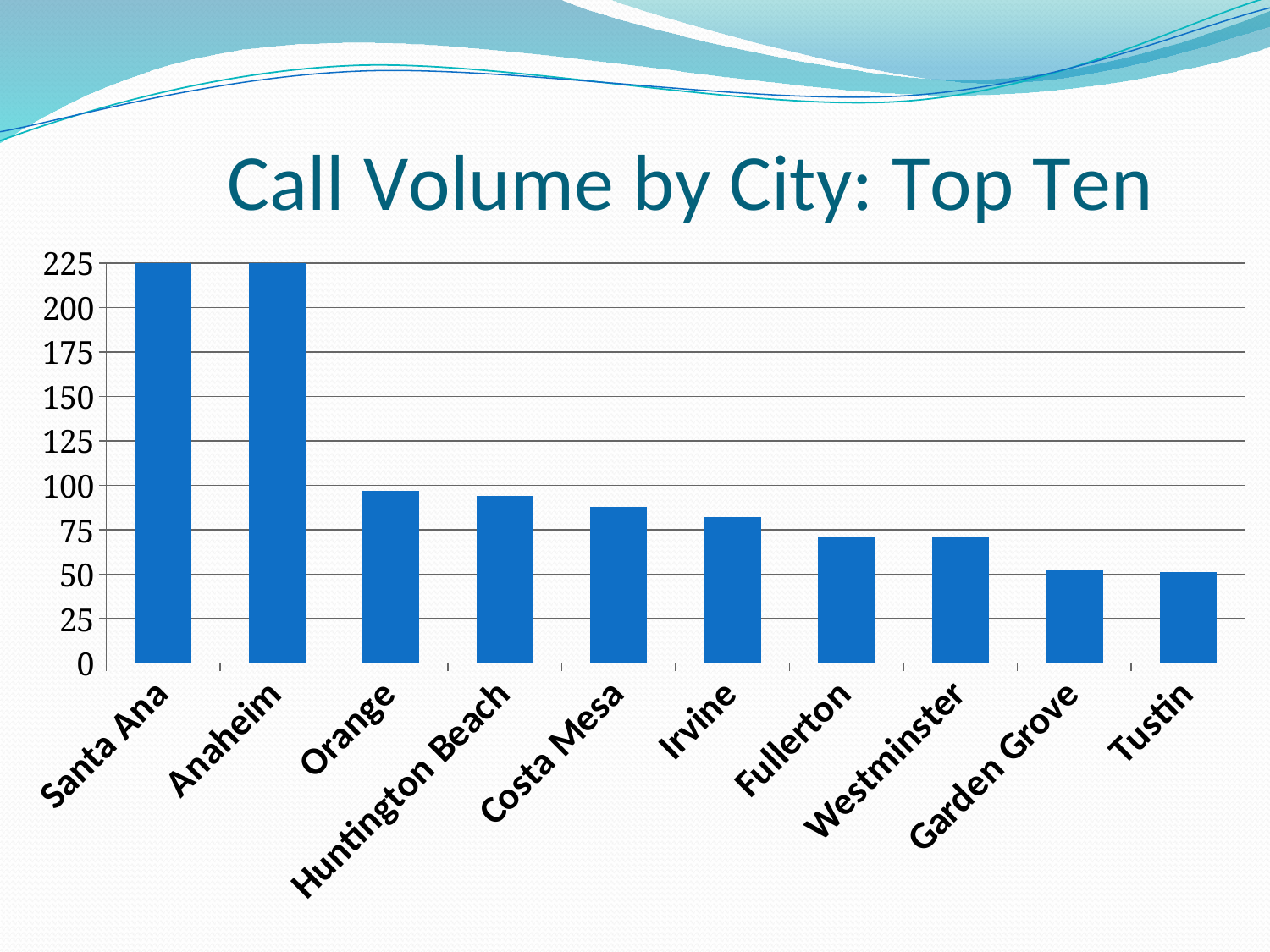
Which city has the larger call volume, Orange or Costa Mesa? Orange Is the value for Costa Mesa greater or less than 75? greater Which city has the larger call volume, Anaheim or Tustin? Anaheim Which city has the larger call volume, Irvine or Garden Grove? Irvine Is the value for Santa Ana greater or less than 200? greater What is the title of the chart? Call Volume by City: Top Ten Is the value for Orange greater or less than 100? less What kind of chart is shown on the slide? Bar chart Do the call volumes generally rise or fall moving from left to right across the cities? Fall How many cities are shown in the chart? 10